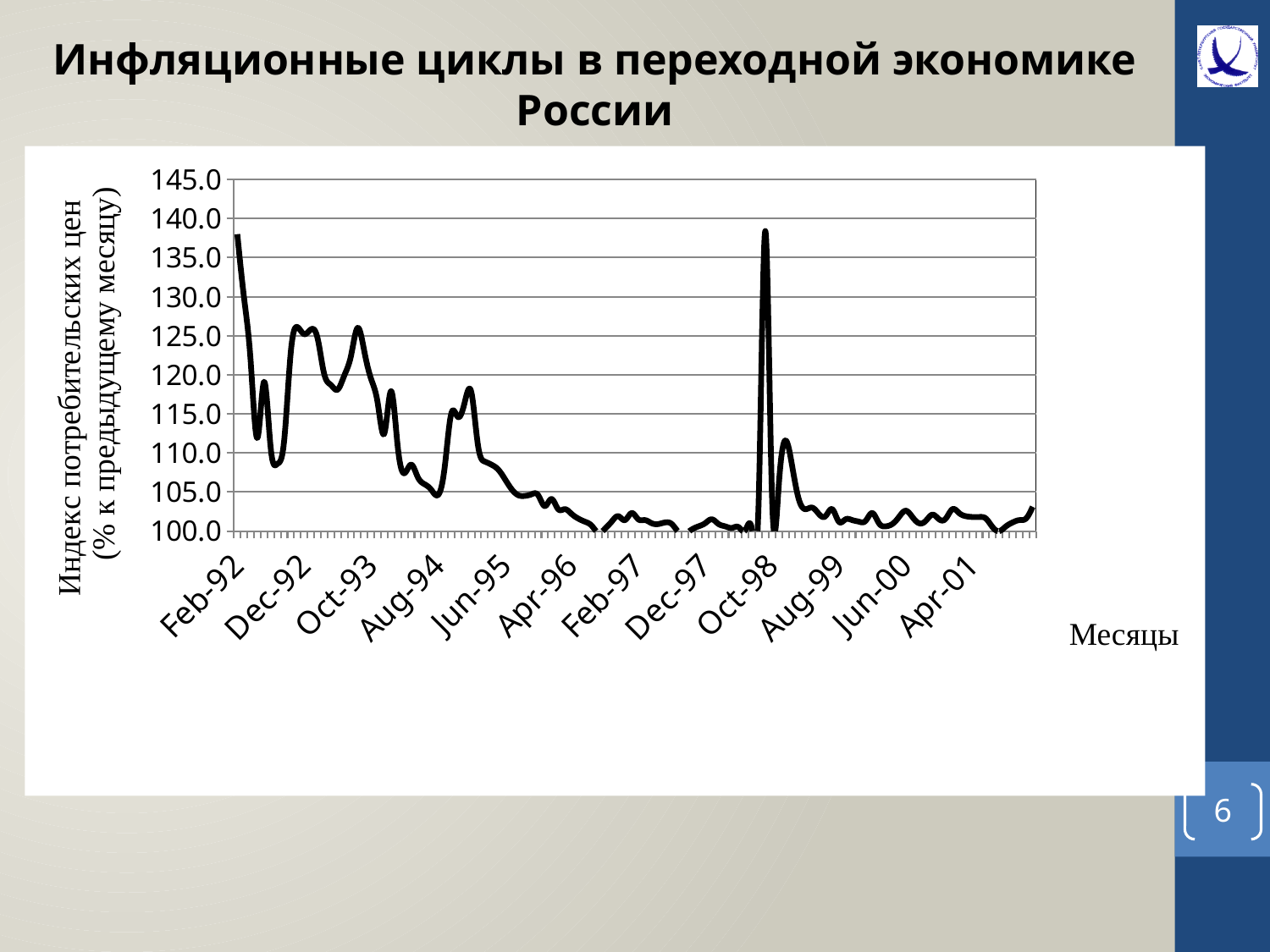
How many month labels are shown on the x axis? 12 Is the value for Dec-92 greater or less than 120? greater What kind of chart is shown on the slide? line chart Which is larger, the value for Feb-92 or the value for Apr-01? Feb-92 Is the value for Feb-92 greater or less than 135? greater Is the value for Aug-94 greater or less than 110? less Overall, do the values rise or fall from Feb-92 to Apr-01? fall What is the label of the x axis? Месяцы Which is larger, the value for Dec-92 or the value for Feb-97? Dec-92